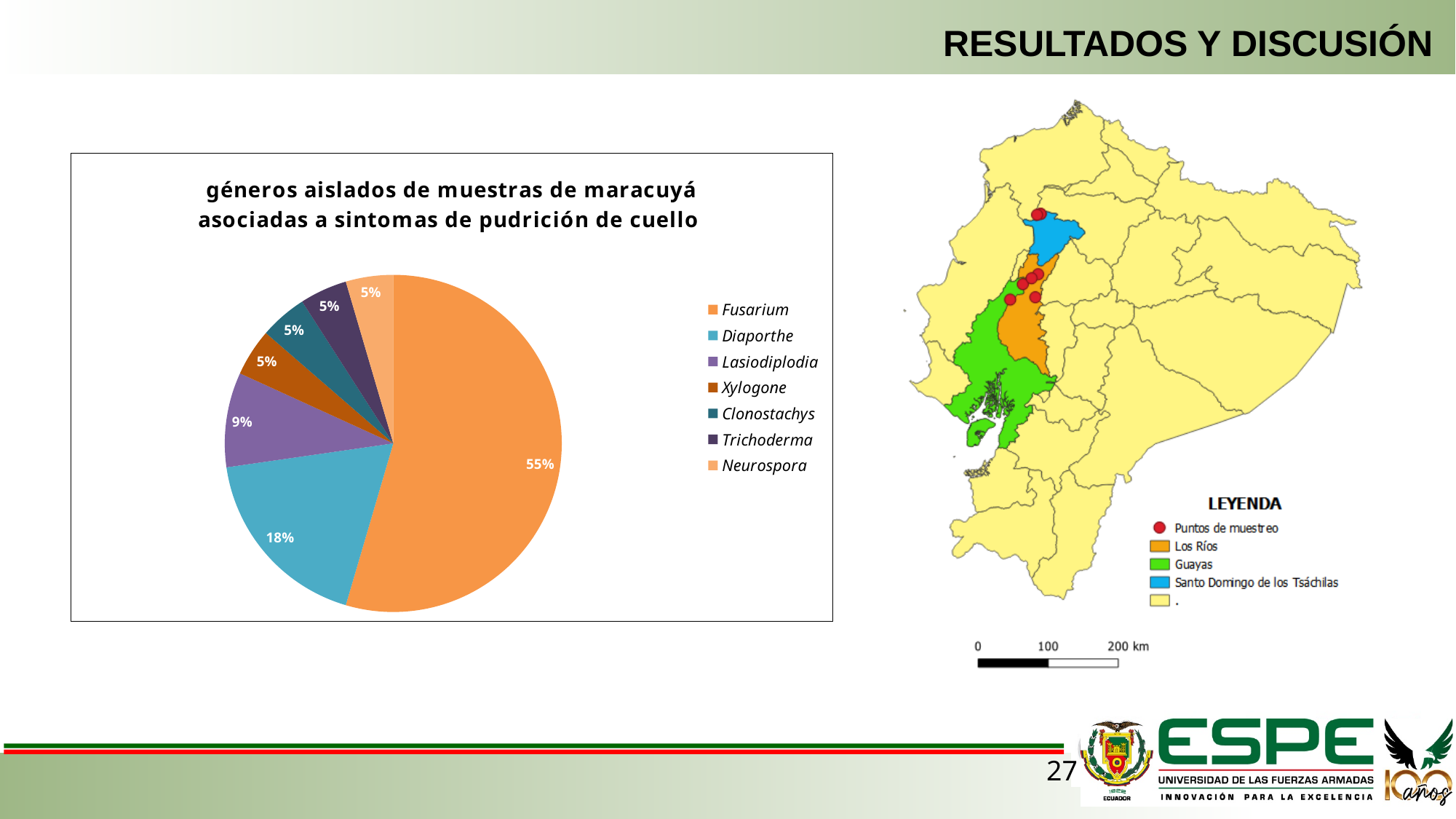
How many entries does the chart legend list? 7 Which legend entry is shown in the lightest orange colour, listed last in the legend? Neurospora Which is larger, the slice for Lasiodiplodia or the slice for Trichoderma? Lasiodiplodia Which genus has the largest slice of the pie? Fusarium What is the difference between the Diaporthe and Lasiodiplodia percentages? 9% What kind of chart is shown on the slide? Pie chart What is the difference between the Fusarium and Diaporthe percentages? 37% What is the value shown for Diaporthe? 18% What share of the pie does Fusarium represent? 55% What percentage is shown for Xylogone? 5% How many genera (slices) are shown in the pie chart? 7 What percentage is shown for Lasiodiplodia? 9%